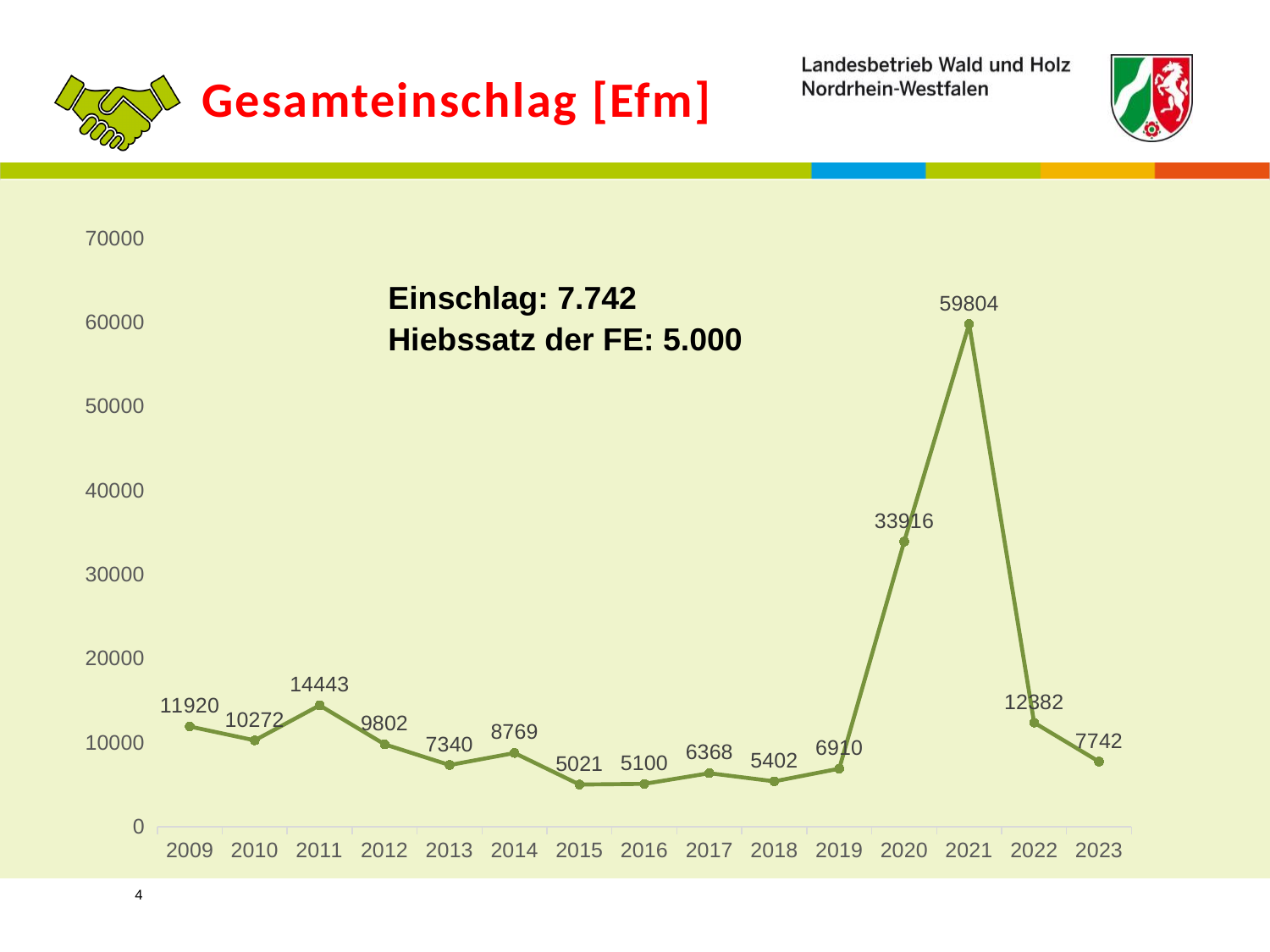
What type of chart is shown on the slide? line chart How many years are plotted on the x axis? 15 What is the value for 2021? 59804 What is the difference between the values for 2022 and 2023? 4640 What is the value for 2023? 7742 Which year has the lowest value? 2015 Do the values rise or fall from 2021 to 2023? fall Is the value for 2020 greater or less than 30000? greater Which year has the highest value? 2021 What is the difference between the values for 2021 and 2020? 25888 Which is larger, the value for 2009 or the value for 2011? 2011 What is the value for 2013? 7340